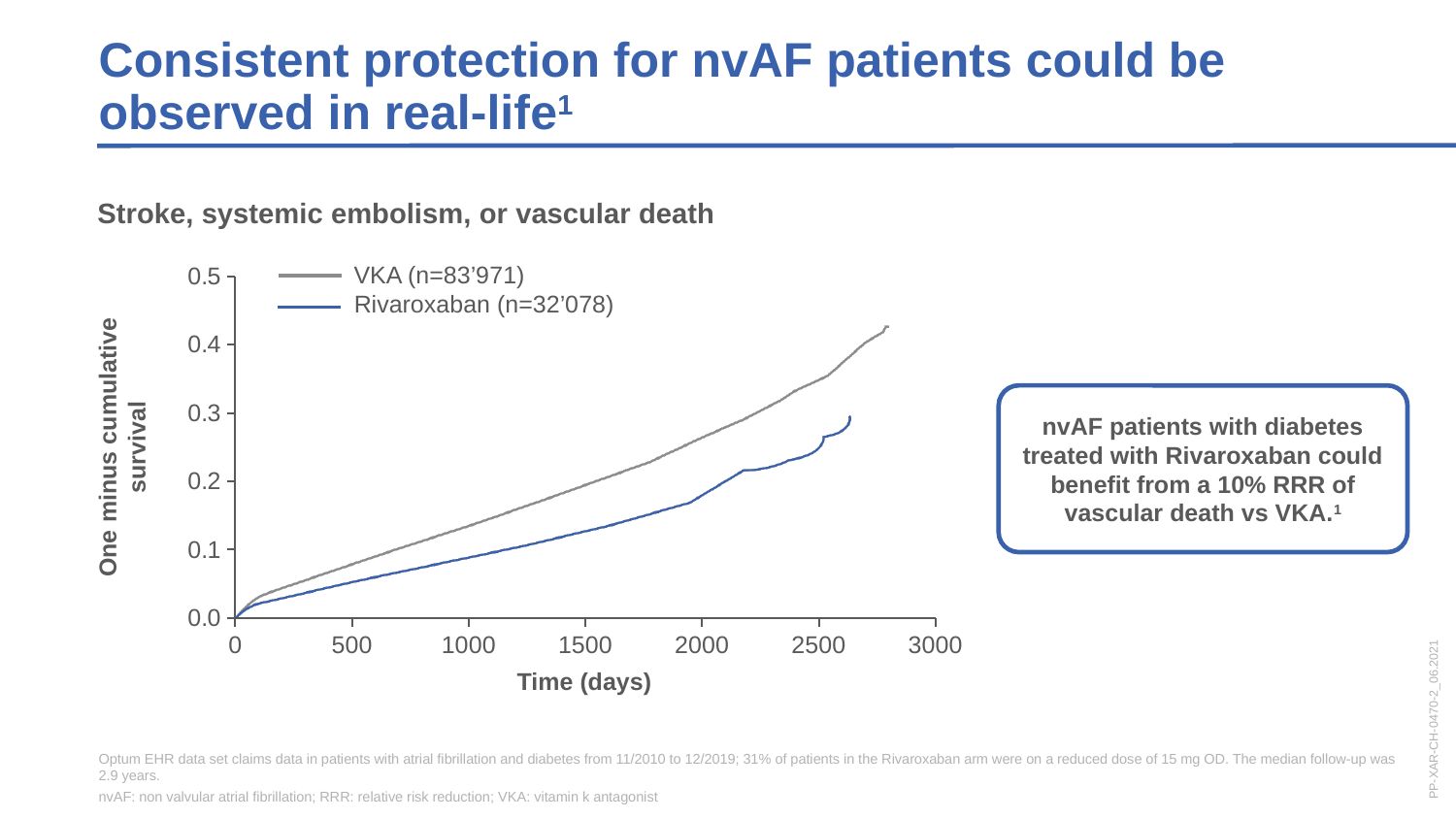
What is the label of the x axis of the chart? Time (days) Is the value for Rivaroxaban at 2500 days greater or less than 0.3? less Which series has the higher value at 2500 days, VKA or Rivaroxaban? VKA Which series stays lowest across the chart? Rivaroxaban (n=32'078) Which two series are shown in the chart legend? VKA (n=83'971) and Rivaroxaban (n=32'078) Is the value for VKA at 2500 days greater or less than 0.3? greater How many series does the chart legend list? 2 Do the values for VKA rise or fall as time increases along the x axis? Rise Is the value for VKA at 1500 days greater or less than 0.1? greater What kind of chart is shown on the slide? Line chart Which series reaches the highest value on the chart? VKA (n=83'971)